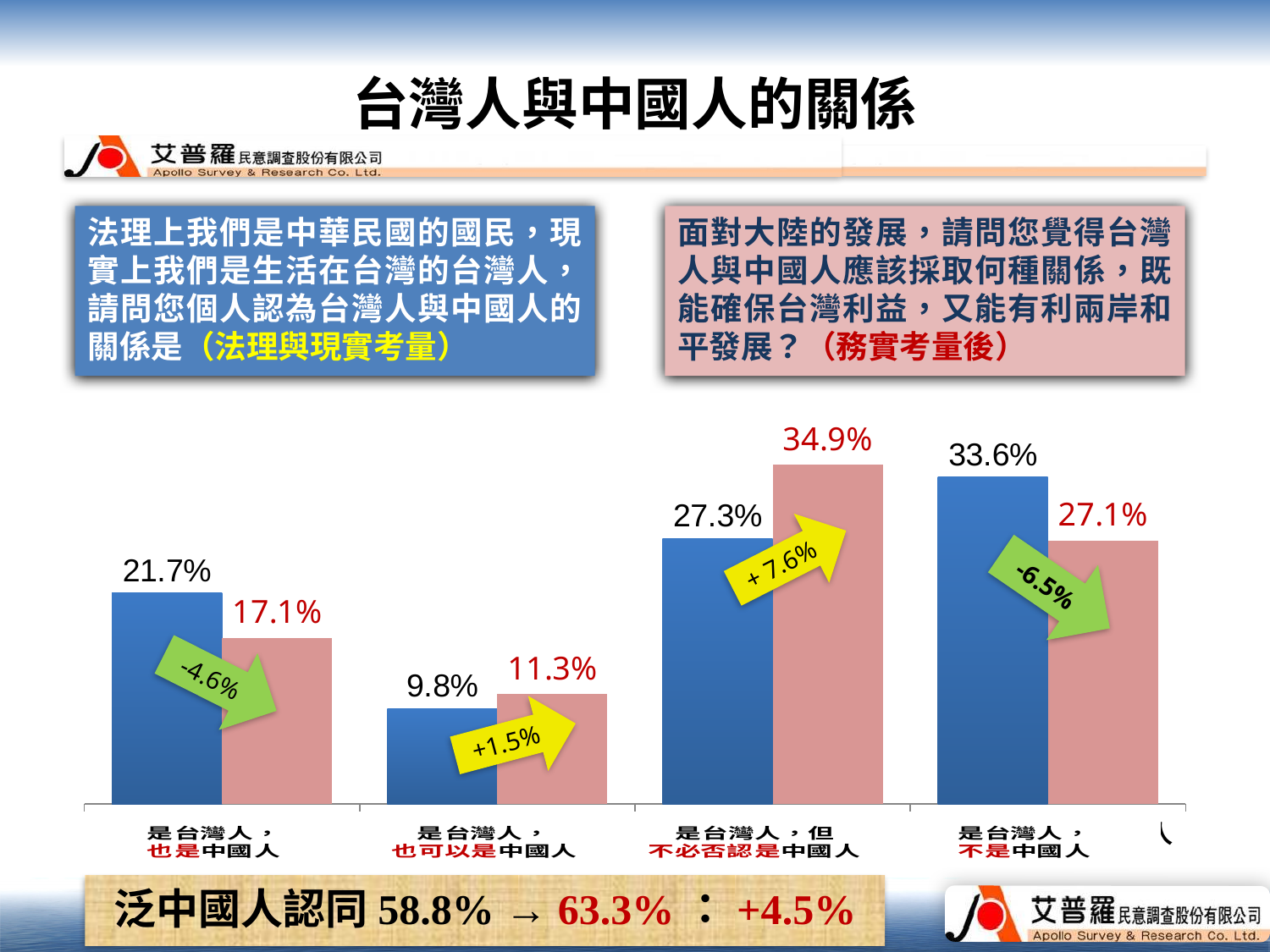
For 是台灣人，也是中國人, which bar is larger, blue or pink? blue What is the difference between the pink and blue bars for 是台灣人，但不必否認是中國人? 7.6% How many categories are shown on the x axis? 4 What kind of chart is shown on the slide? bar chart Which category has the highest blue bar? 是台灣人，不是中國人 What is the blue bar value for 是台灣人，也是中國人? 21.7% What is the pink bar value for 是台灣人，但不必否認是中國人? 34.9% What is the pink bar value for 是台灣人，也可以是中國人? 11.3% What is the blue bar value for 是台灣人，不是中國人? 33.6% Which category has the lowest pink bar? 是台灣人，也可以是中國人 What is the difference between the blue and pink bars for 是台灣人，不是中國人? 6.5% What is the change shown by the arrow for 是台灣人，也可以是中國人? +1.5%